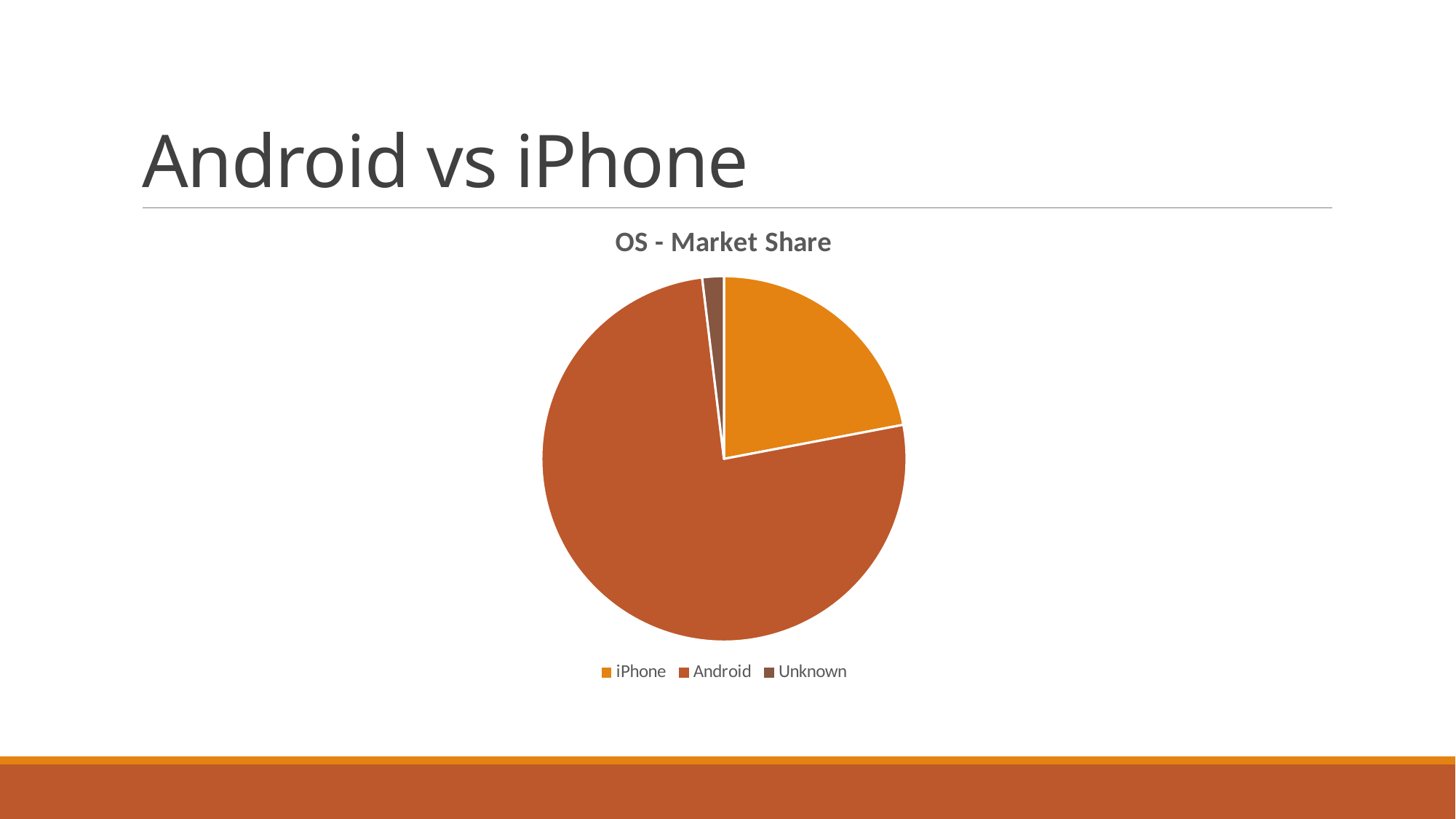
Which slice is smaller, Android or Unknown? Unknown Which category has the smallest slice of the pie? Unknown Which category has the largest slice of the pie? Android What are the three categories listed in the legend? iPhone, Android, Unknown Which slice is larger, iPhone or Android? Android How many slices does the pie chart have? 3 How many entries does the legend list? 3 What kind of chart is shown on the slide? pie chart Which slice is larger, iPhone or Unknown? iPhone What is the title of the chart? OS - Market Share